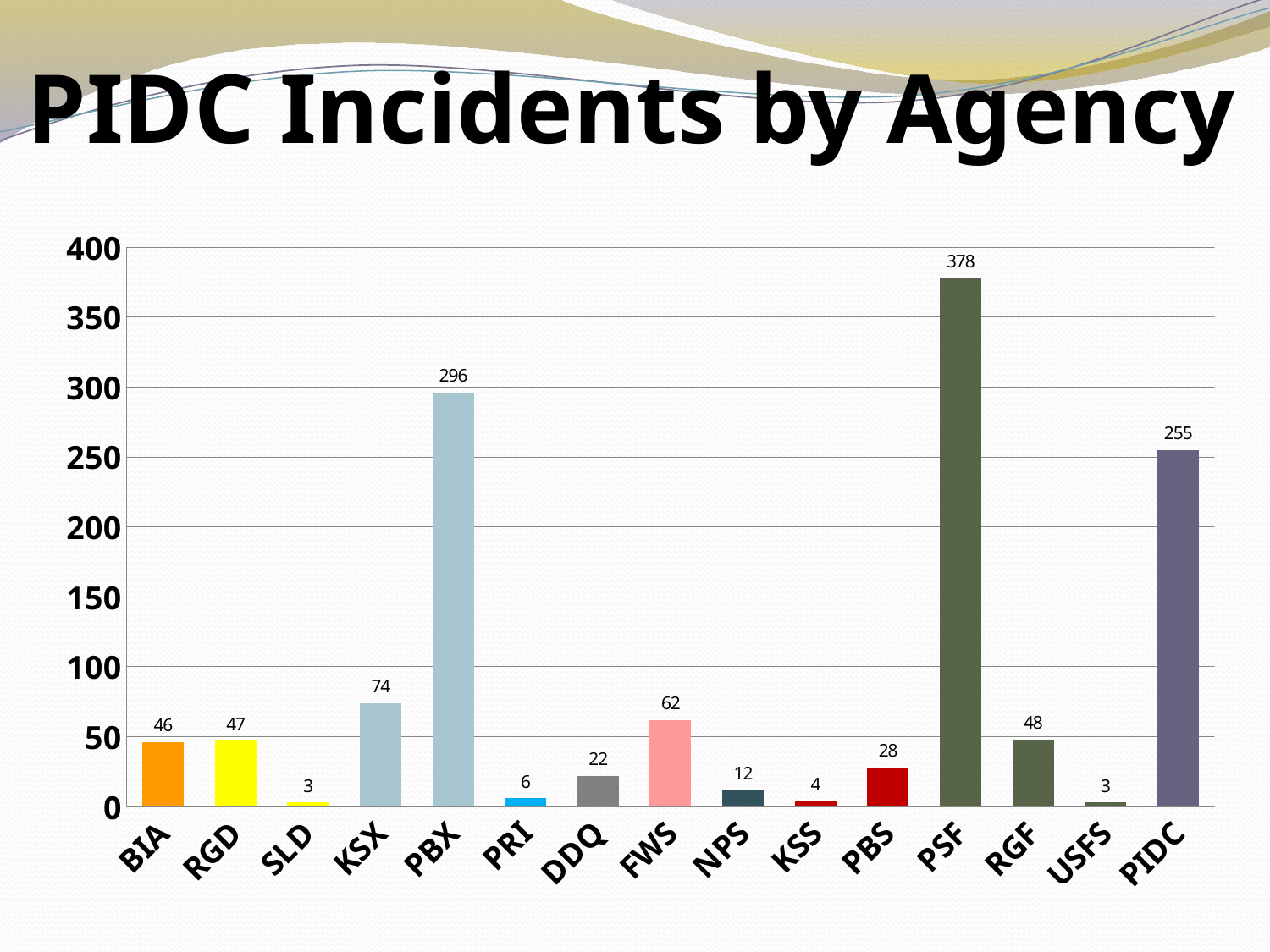
What is the value for FWS? 62 What is the value for PIDC? 255 Is the value for PIDC greater or less than 250? greater How many agencies are shown on the x axis? 15 What is the value for PSF? 378 Which is larger, the value for BIA or the value for RGD? RGD What is the value for PBX? 296 What kind of chart is shown on the slide? bar chart What is the difference between the values for PSF and PBX? 82 What is the title of the chart? PIDC Incidents by Agency What is the difference between the values for KSX and RGF? 26 Which agency has the highest number of incidents? PSF